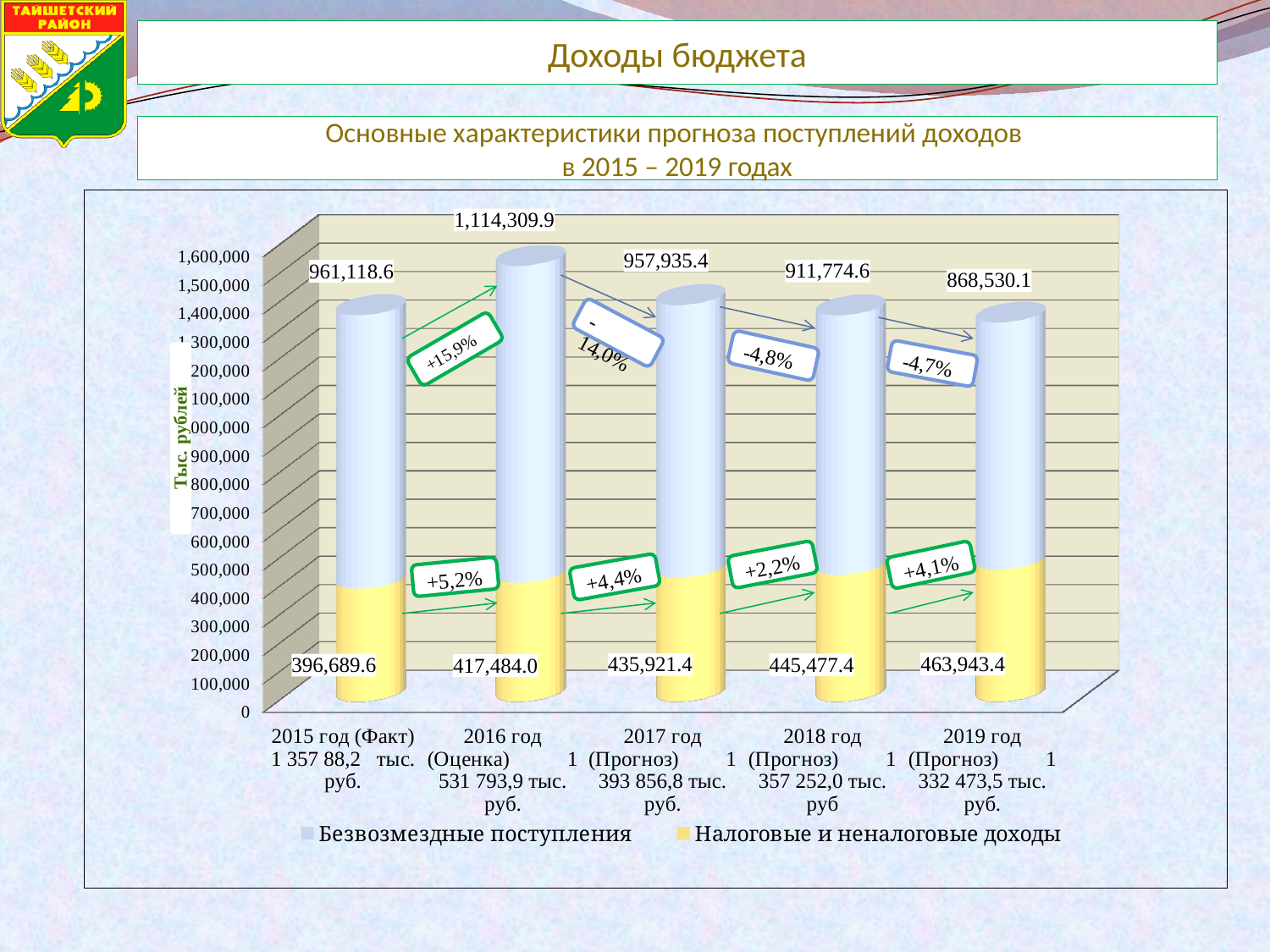
What is the value of Налоговые и неналоговые доходы for 2019 год (Прогноз)? 463,943.4 In which year is Безвозмездные поступления highest? 2016 год (Оценка) How many series does the legend list? 2 In which year is Налоговые и неналоговые доходы lowest? 2015 год (Факт) What is the total of the stacked bar for 2016 год (Оценка)? 1,531,793.9 What kind of chart is shown? Stacked bar chart What is the value of Безвозмездные поступления for 2018 год (Прогноз)? 911,774.6 Which is larger: Безвозмездные поступления in 2017 год or in 2019 год? 2017 год How many years are shown on the x axis? 5 What is the difference between Безвозмездные поступления in 2016 год and in 2015 год? 153,191.3 Do the values of Налоговые и неналоговые доходы rise or fall from 2015 to 2019? Rise What is the value of Безвозмездные поступления for 2016 год (Оценка)? 1,114,309.9